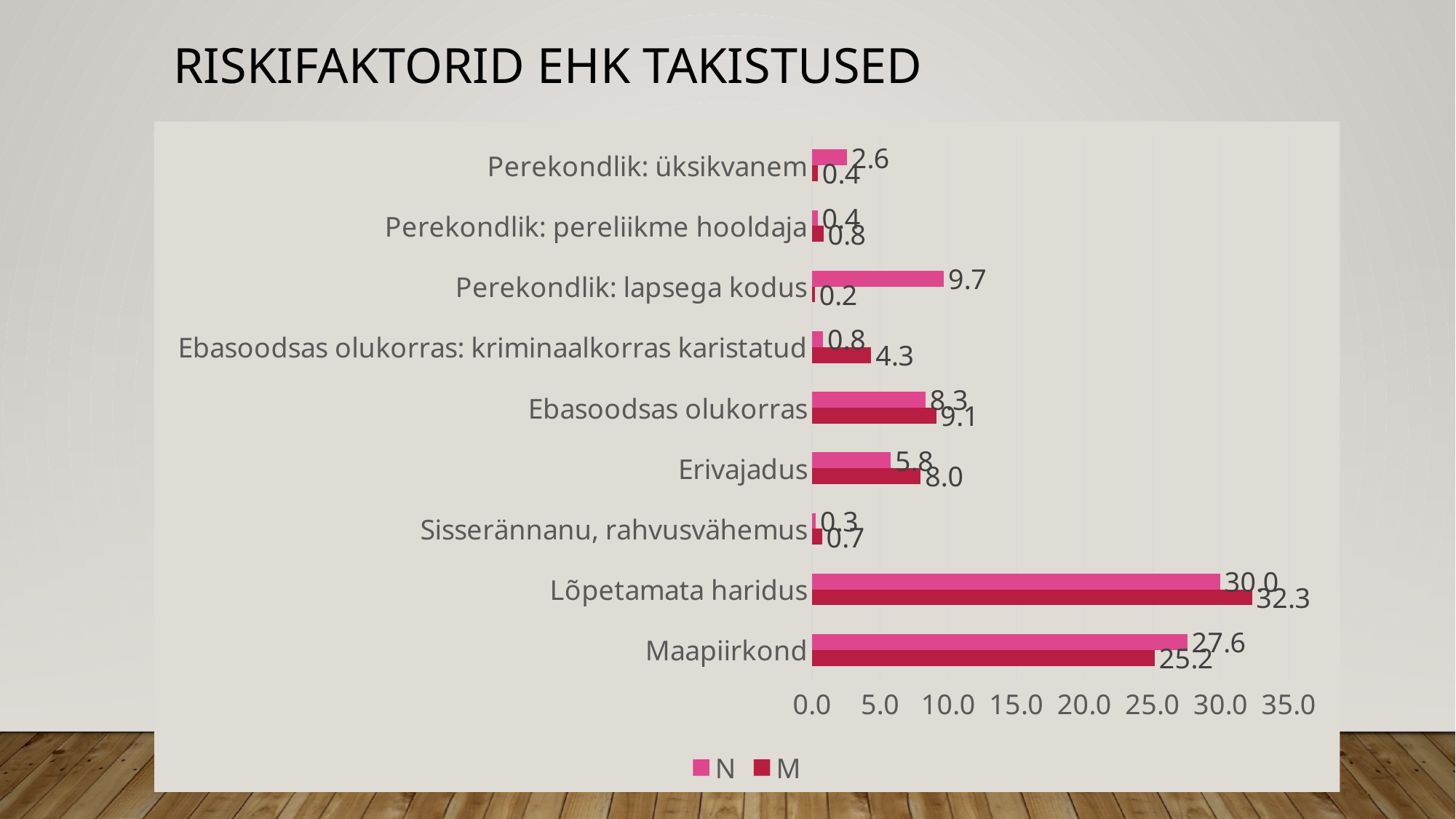
What type of chart is shown on the slide? Bar chart Which category has the lowest M value? Perekondlik: lapsega kodus What is the N value for Perekondlik: lapsega kodus? 9.7 Which category has the highest M value? Lõpetamata haridus What is the N value for Lõpetamata haridus? 30.0 How many categories are shown on the chart? 9 How many series does the legend list? 2 What is the M value for Maapiirkond? 25.2 What is the difference between the M and N values for Lõpetamata haridus? 2.3 For Erivajadus, which series has the larger value, N or M? M What is the difference between the N and M values for Maapiirkond? 2.4 What is the M value for Ebasoodsas olukorras: kriminaalkorras karistatud? 4.3